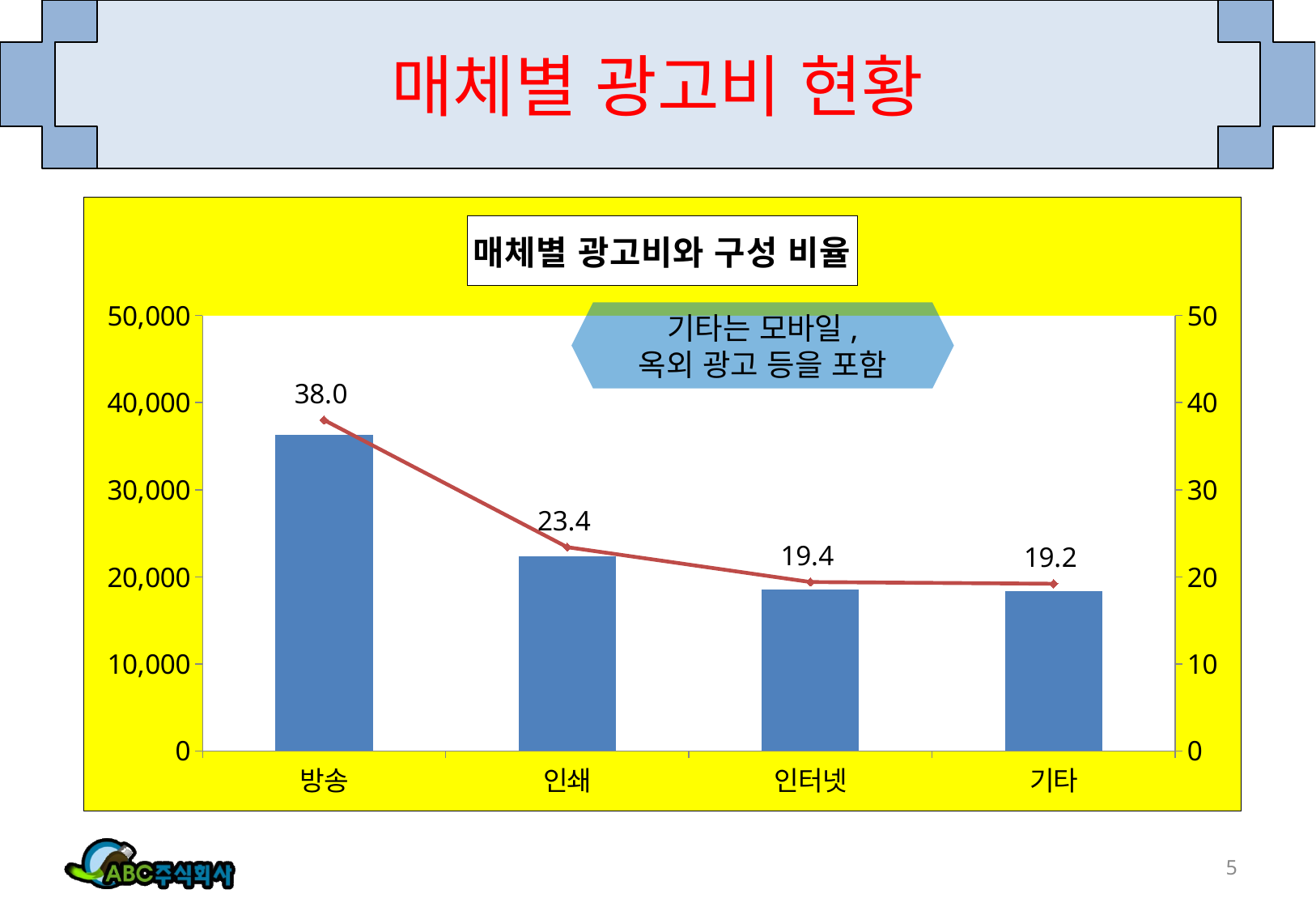
Which category has the highest composition ratio on the line? 방송 Is the bar for 인터넷 greater or less than 20,000? less Do the composition ratio values rise or fall from 방송 to 기타 along the x axis? fall What is the composition ratio value shown for 방송? 38.0 What is the composition ratio value shown for 인쇄? 23.4 What is the title of the chart? 매체별 광고비와 구성 비율 Which category has the lowest composition ratio on the line? 기타 What is the composition ratio value shown for 기타? 19.2 How many categories are shown on the x axis? 4 What is the difference between the composition ratio of 방송 and 인쇄? 14.6 What is the composition ratio value shown for 인터넷? 19.4 Is the bar for 방송 greater or less than 30,000? greater